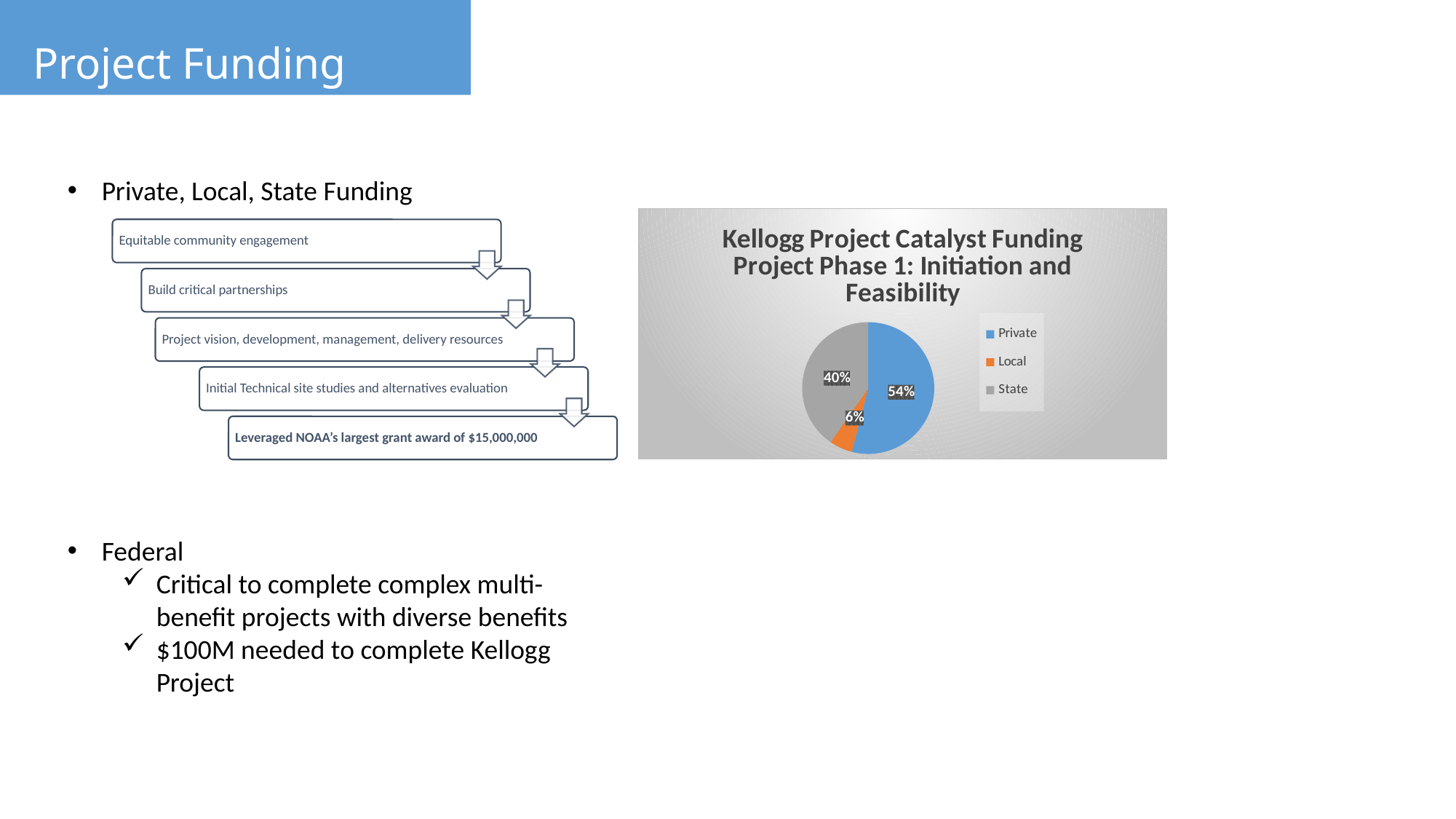
What kind of chart is shown on the slide? pie chart What share of the pie does Private represent? 54% What share of the pie does State represent? 40% What is the title of the pie chart? Kellogg Project Catalyst Funding Project Phase 1: Initiation and Feasibility Which funding source has the largest share of the pie? Private What share of the pie does Local represent? 6% Which is larger, the Private share or the State share? Private How many slices does the pie chart have? 3 What is the difference in percentage points between the State and Local shares? 34 What is the difference in percentage points between the Private and State shares? 14 Which funding source has the smallest share of the pie? Local Which colour represents Local in the pie chart? orange